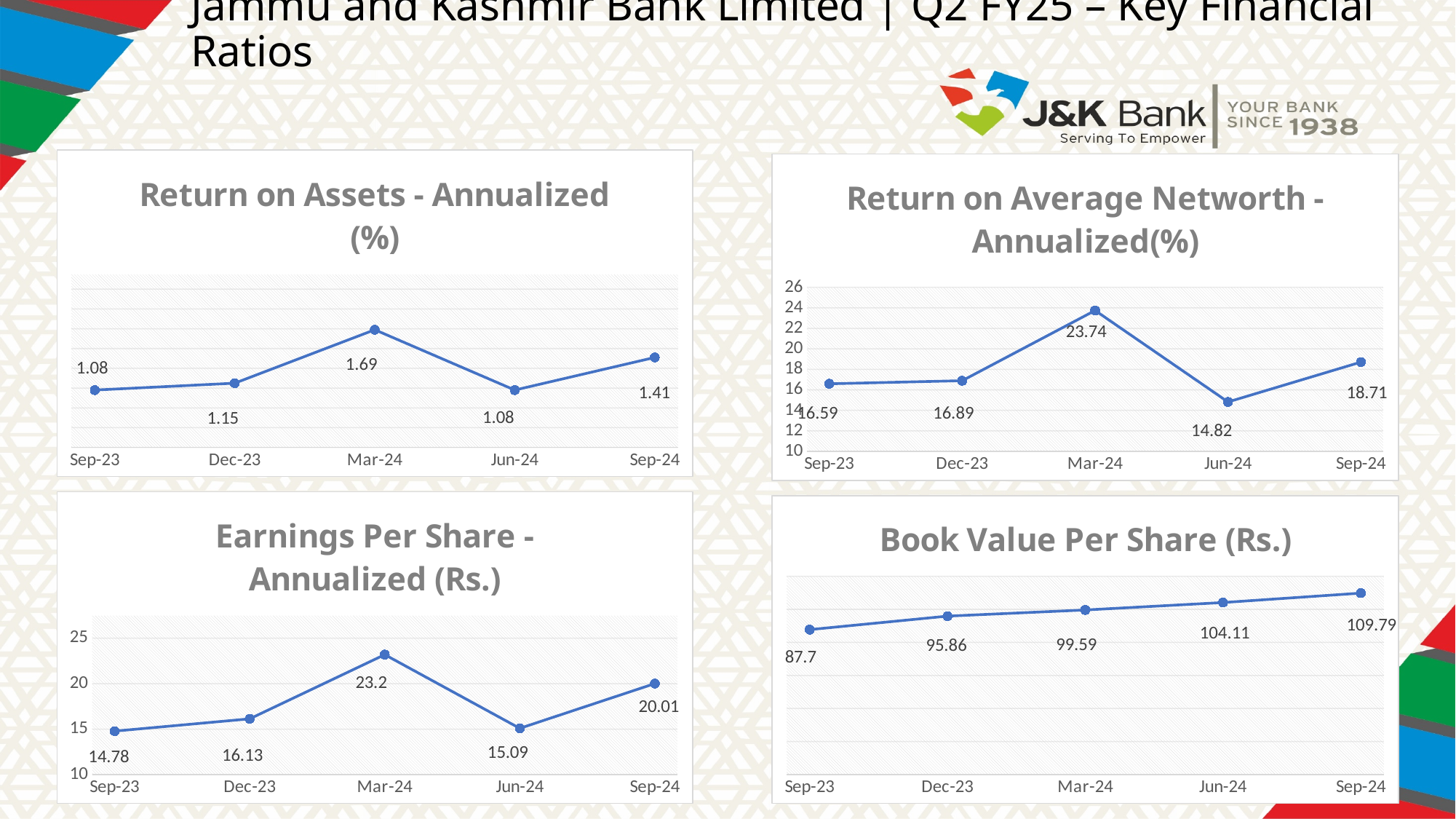
In the 'Return on Average Networth - Annualized(%)' chart, what is the value for Dec-23? 16.89 In the 'Return on Assets - Annualized (%)' chart, what is the value for Sep-24? 1.41 In the 'Earnings Per Share - Annualized (Rs.)' chart, which period has the highest value? Mar-24 In the 'Book Value Per Share (Rs.)' chart, what is the value for Jun-24? 104.11 In the 'Return on Average Networth - Annualized(%)' chart, what is the difference between the Mar-24 and Jun-24 values? 8.92 In the 'Return on Average Networth - Annualized(%)' chart, which period has the lowest value? Jun-24 In the 'Earnings Per Share - Annualized (Rs.)' chart, what is the value for Sep-23? 14.78 What type of chart is the 'Return on Assets - Annualized (%)' chart? line chart How many data points are plotted in the 'Book Value Per Share (Rs.)' chart? 5 In the 'Book Value Per Share (Rs.)' chart, do the values rise or fall from Sep-23 to Sep-24? rise In the 'Earnings Per Share - Annualized (Rs.)' chart, is the value for Sep-24 larger or smaller than the value for Dec-23? larger In the 'Return on Assets - Annualized (%)' chart, what is the value for Mar-24? 1.69